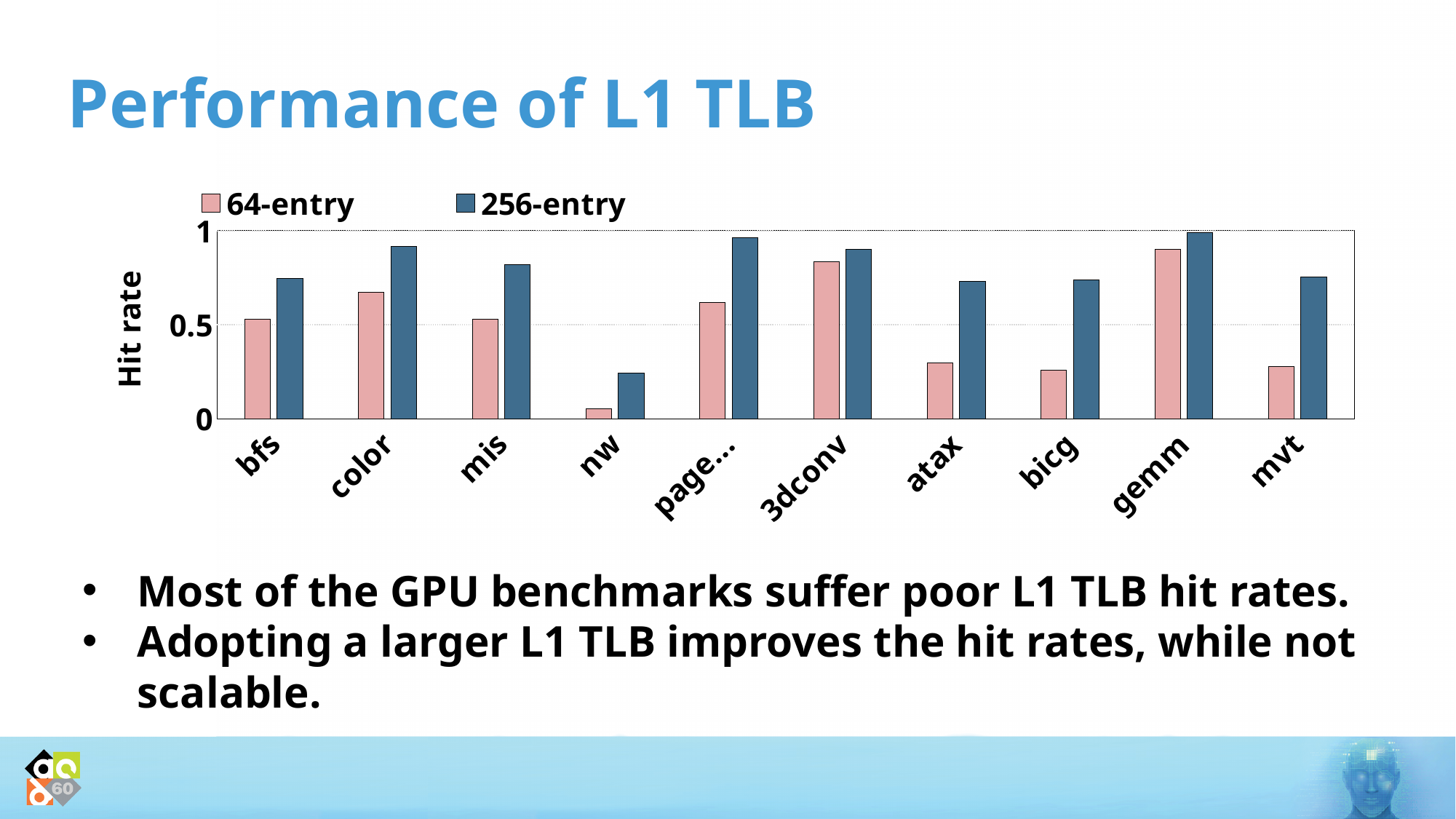
Is the 64-entry hit rate for atax greater or less than 0.5? less Which benchmark has the lowest 64-entry hit rate? nw Which is larger for color: the 64-entry hit rate or the 256-entry hit rate? 256-entry Is the 64-entry hit rate for 3dconv greater or less than 0.5? greater Which benchmark has the lowest 256-entry hit rate? nw How many series does the legend list? 2 What is the label of the y axis? Hit rate Is the 64-entry hit rate for nw greater or less than 0.5? less Which benchmark has the highest 64-entry hit rate? gemm What kind of chart is shown on the slide? bar chart How many benchmark categories are shown on the x axis? 10